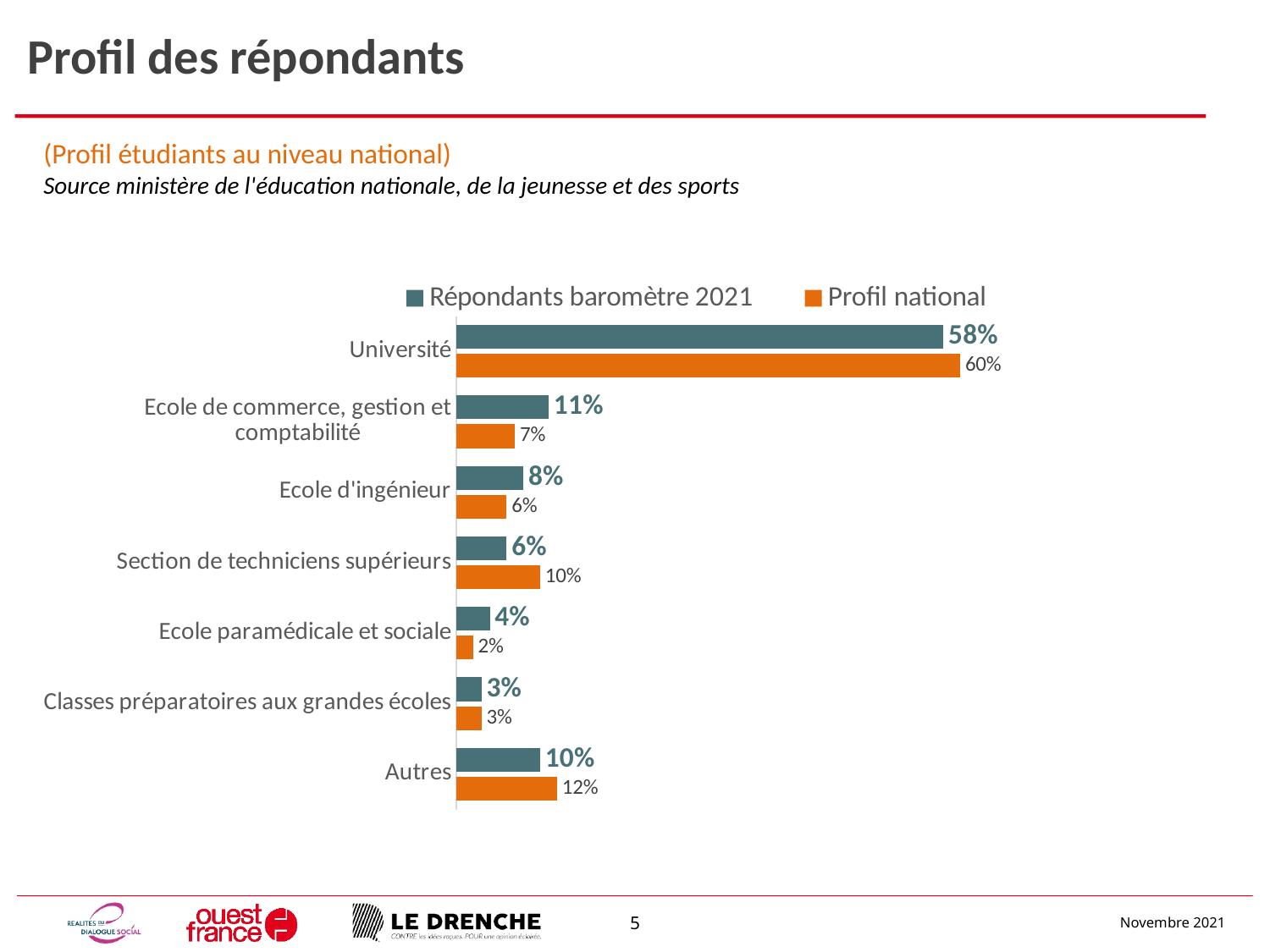
Which category has the lowest value in the Profil national series? Ecole paramédicale et sociale What is the Répondants baromètre 2021 value for Ecole de commerce, gestion et comptabilité? 11% What is the difference between the Profil national and Répondants baromètre 2021 values for Université? 2% Which category has the highest value in the Profil national series? Université What is the Profil national value for Section de techniciens supérieurs? 10% What kind of chart is shown on the slide? Bar chart What is the Profil national value for Autres? 12% How many categories are shown on the chart? 7 What is the value for Université in the Répondants baromètre 2021 series? 58% Which colour represents the Profil national series? Orange How many series does the legend list? 2 For Ecole d'ingénieur, which series has the larger value: Répondants baromètre 2021 or Profil national? Répondants baromètre 2021